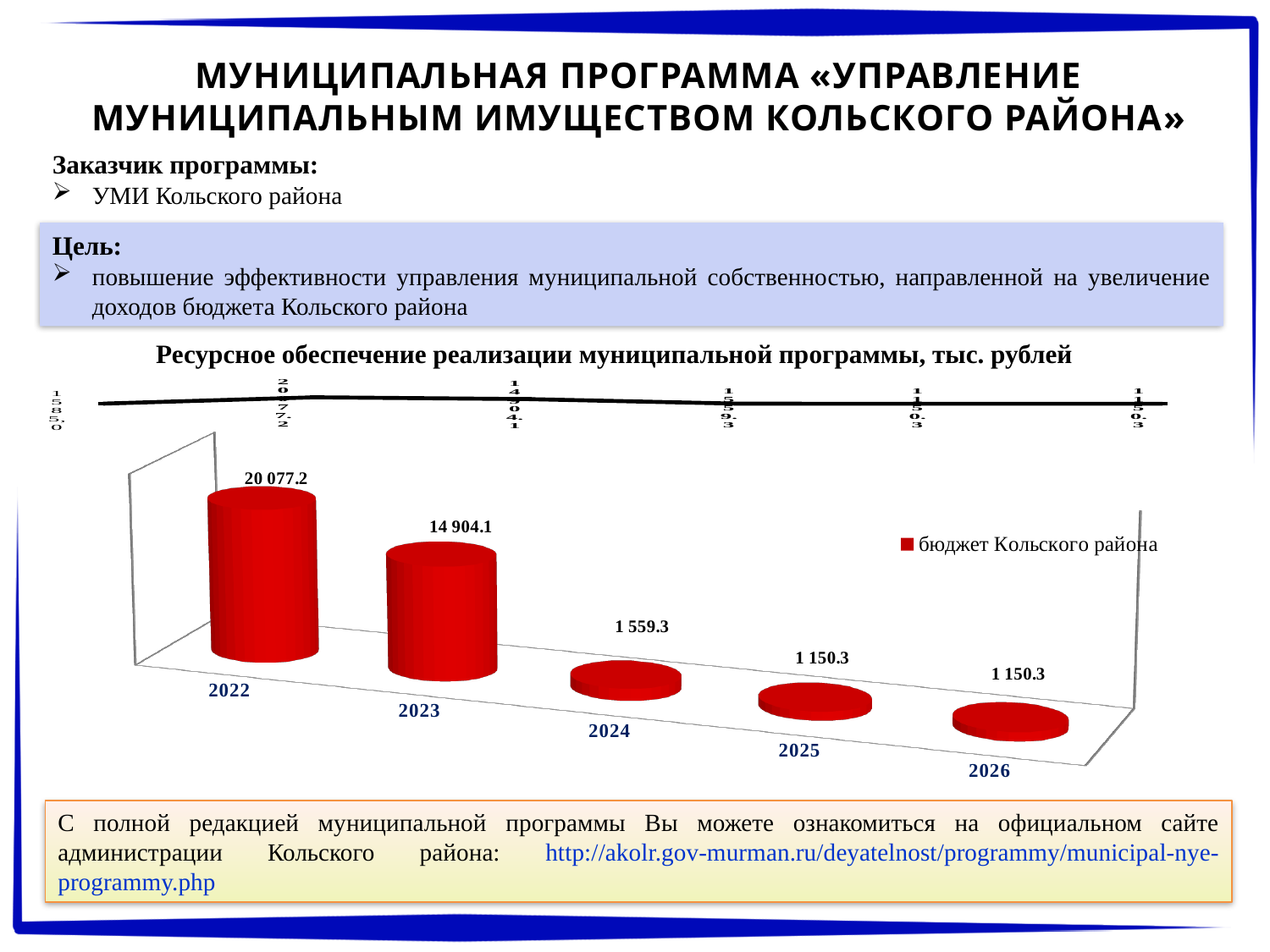
What is the value for 2022 in the chart? 20 077.2 Which year has the highest value in the chart? 2022 What is the difference between the values for 2022 and 2023? 5 173.1 What kind of chart is used to show the resource provision data? bar chart What is the value for 2026 in the chart? 1 150.3 What is the difference between the values for 2024 and 2025? 409.0 Which is larger, the value for 2023 or the value for 2024? 2023 How many years are shown on the x axis of the chart? 5 What is the value for 2024 in the chart? 1 559.3 What is the value for 2023 in the chart? 14 904.1 Do the values rise or fall from 2022 to 2026? fall What series name is shown in the chart legend? бюджет Кольского района